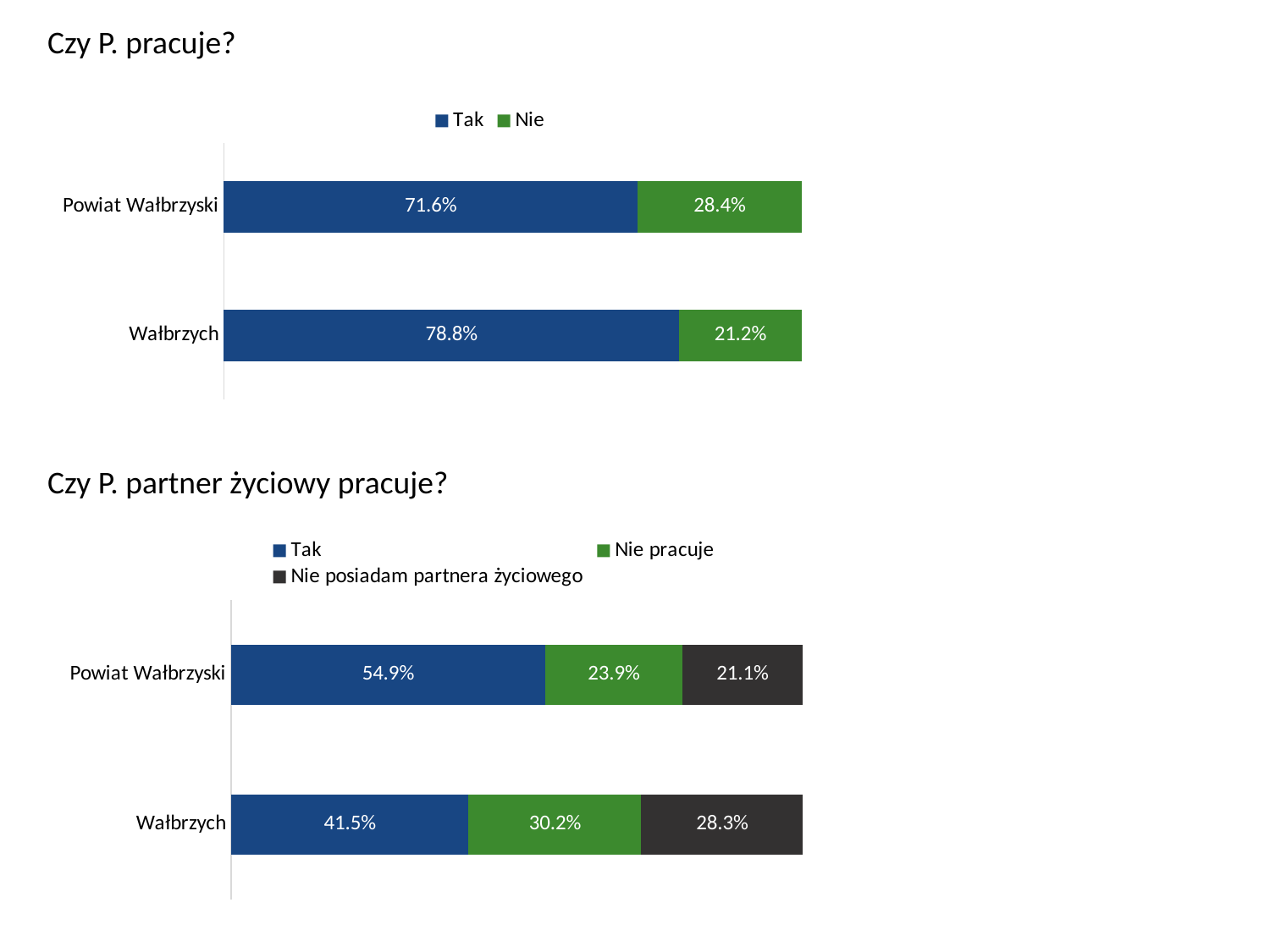
In the chart titled "Czy P. pracuje?", which category has the higher "Nie" value? Powiat Wałbrzyski In the chart titled "Czy P. partner życiowy pracuje?", which category has the higher "Tak" value? Powiat Wałbrzyski In the chart titled "Czy P. pracuje?", how many series does the legend list? 2 In the chart titled "Czy P. pracuje?", what is the difference between the "Tak" values for Wałbrzych and Powiat Wałbrzyski? 7.2% In the chart titled "Czy P. partner życiowy pracuje?", what is the value of "Nie posiadam partnera życiowego" for Wałbrzych? 28.3% In the chart titled "Czy P. partner życiowy pracuje?", what is the value of "Tak" for Powiat Wałbrzyski? 54.9% In the chart titled "Czy P. partner życiowy pracuje?", how many series does the legend list? 3 What type of chart is the chart titled "Czy P. partner życiowy pracuje?"? Stacked bar chart In the chart titled "Czy P. pracuje?", what is the value of "Tak" for Wałbrzych? 78.8% In the chart titled "Czy P. partner życiowy pracuje?", what is the value of "Nie pracuje" for Powiat Wałbrzyski? 23.9% In the chart titled "Czy P. partner życiowy pracuje?", what is the difference between the "Nie pracuje" values for Wałbrzych and Powiat Wałbrzyski? 6.3% In the chart titled "Czy P. pracuje?", what is the value of "Nie" for Powiat Wałbrzyski? 28.4%